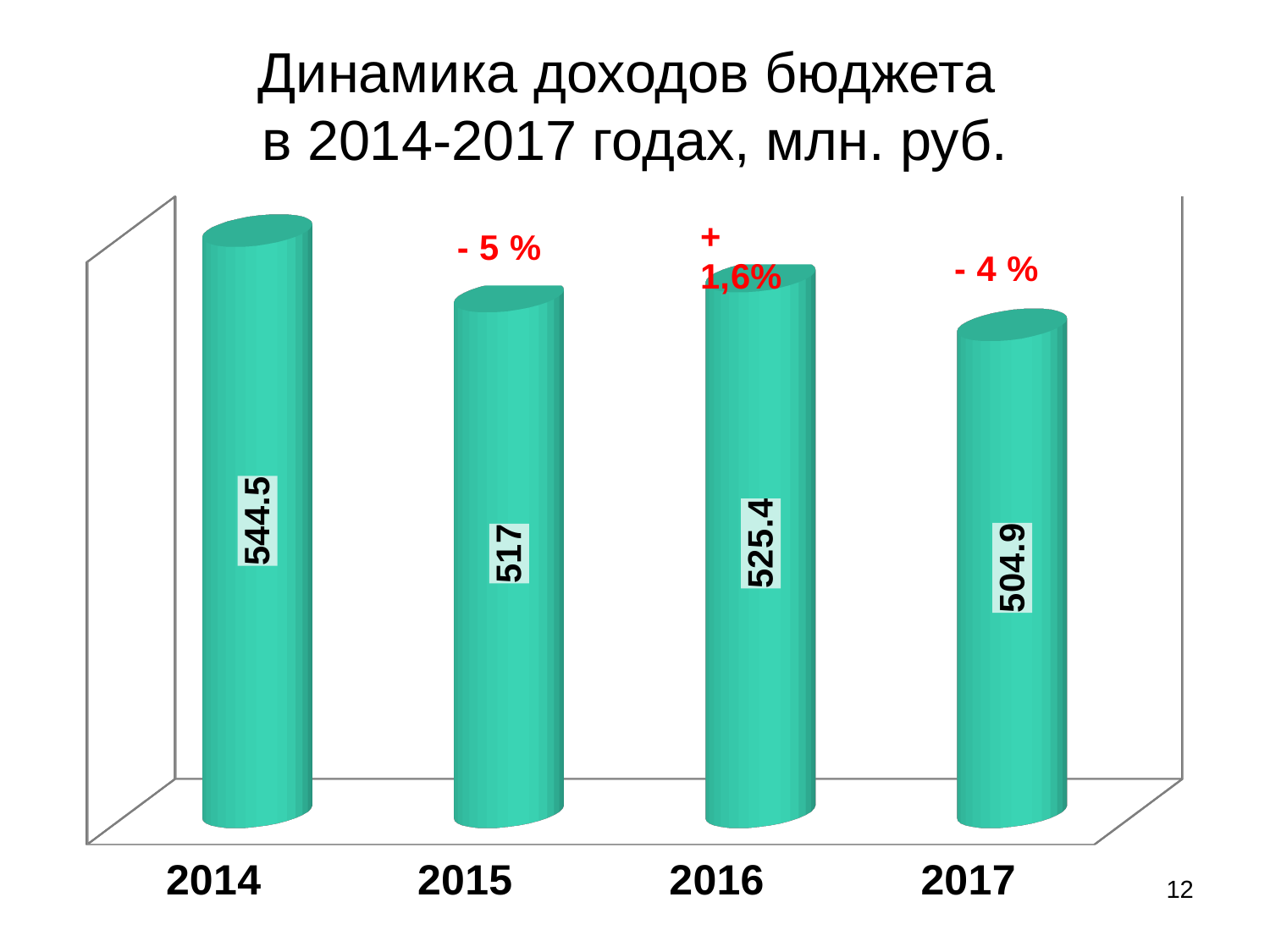
What is the budget revenue value shown for 2015? 517 How many years are shown on the chart? 4 What kind of chart is shown on the slide? bar chart Which year has the lowest budget revenue? 2017 What is the budget revenue value shown for 2017? 504.9 What is the budget revenue value shown for 2014? 544.5 What is the difference between the 2016 and 2017 values? 20.5 Which year has the larger value, 2015 or 2016? 2016 Which year has the highest budget revenue? 2014 What is the difference between the 2014 and 2015 values? 27.5 What is the budget revenue value shown for 2016? 525.4 What percentage change is annotated above the 2016 bar? + 1,6%